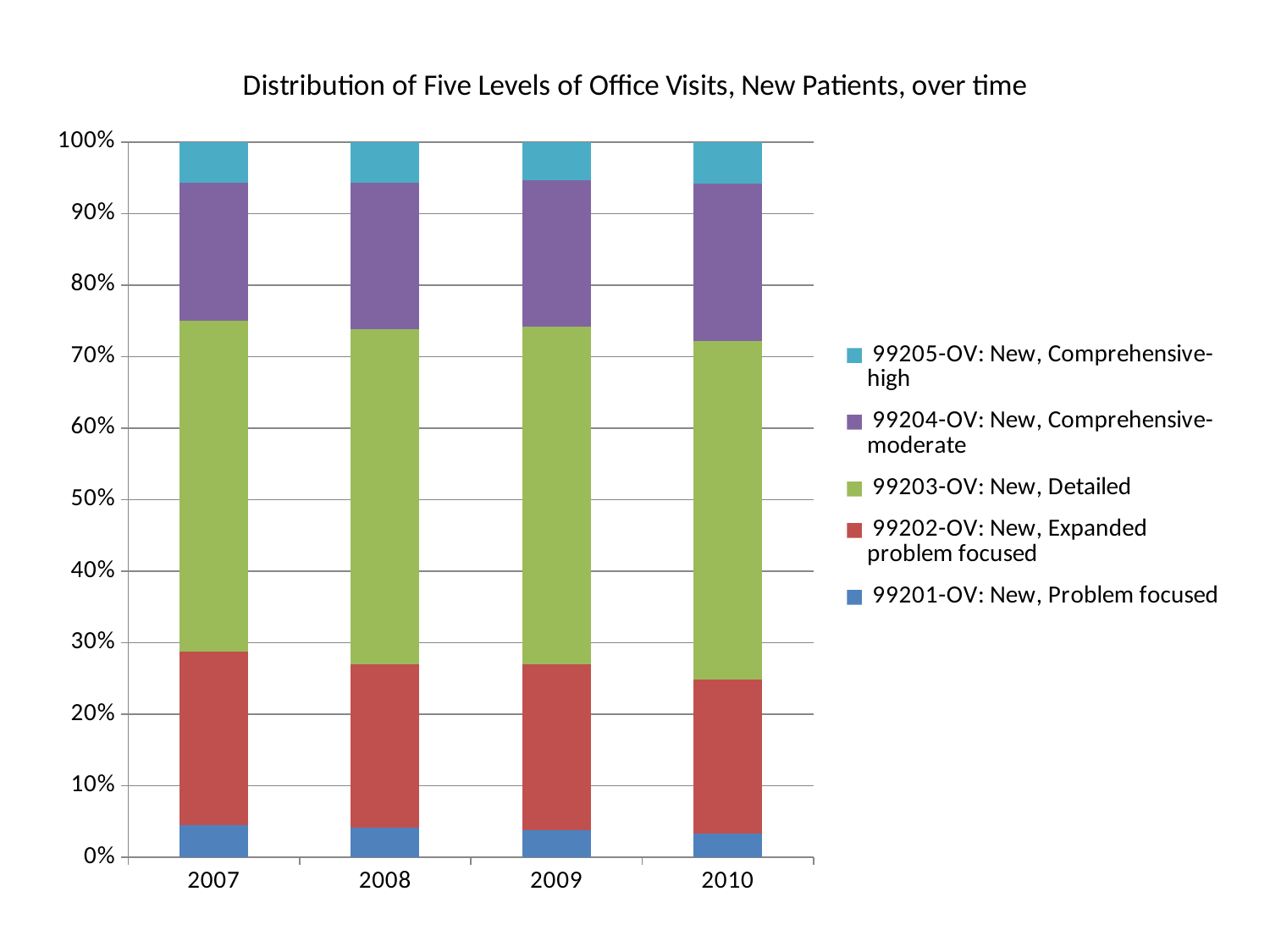
How many years are shown on the x axis of the chart? 4 Does the share for 99201-OV: New, Problem focused rise or fall from 2007 to 2010? fall How many series does the legend list? 5 Is the share for 99201-OV: New, Problem focused in 2010 greater or less than 10%? less Which series makes up the smallest share of the 2010 bar? 99201-OV: New, Problem focused Is the share for 99203-OV: New, Detailed in 2007 greater or less than 40%? greater What is the title of the chart? Distribution of Five Levels of Office Visits, New Patients, over time What kind of chart is shown on the slide? Stacked bar chart Is the share for 99205-OV: New, Comprehensive-high in 2009 greater or less than 10%? less In 2008, which is larger: the share for 99203-OV: New, Detailed or the share for 99202-OV: New, Expanded problem focused? 99203-OV: New, Detailed Which series makes up the largest share of the 2010 bar? 99203-OV: New, Detailed Which series is shown in green in the legend? 99203-OV: New, Detailed